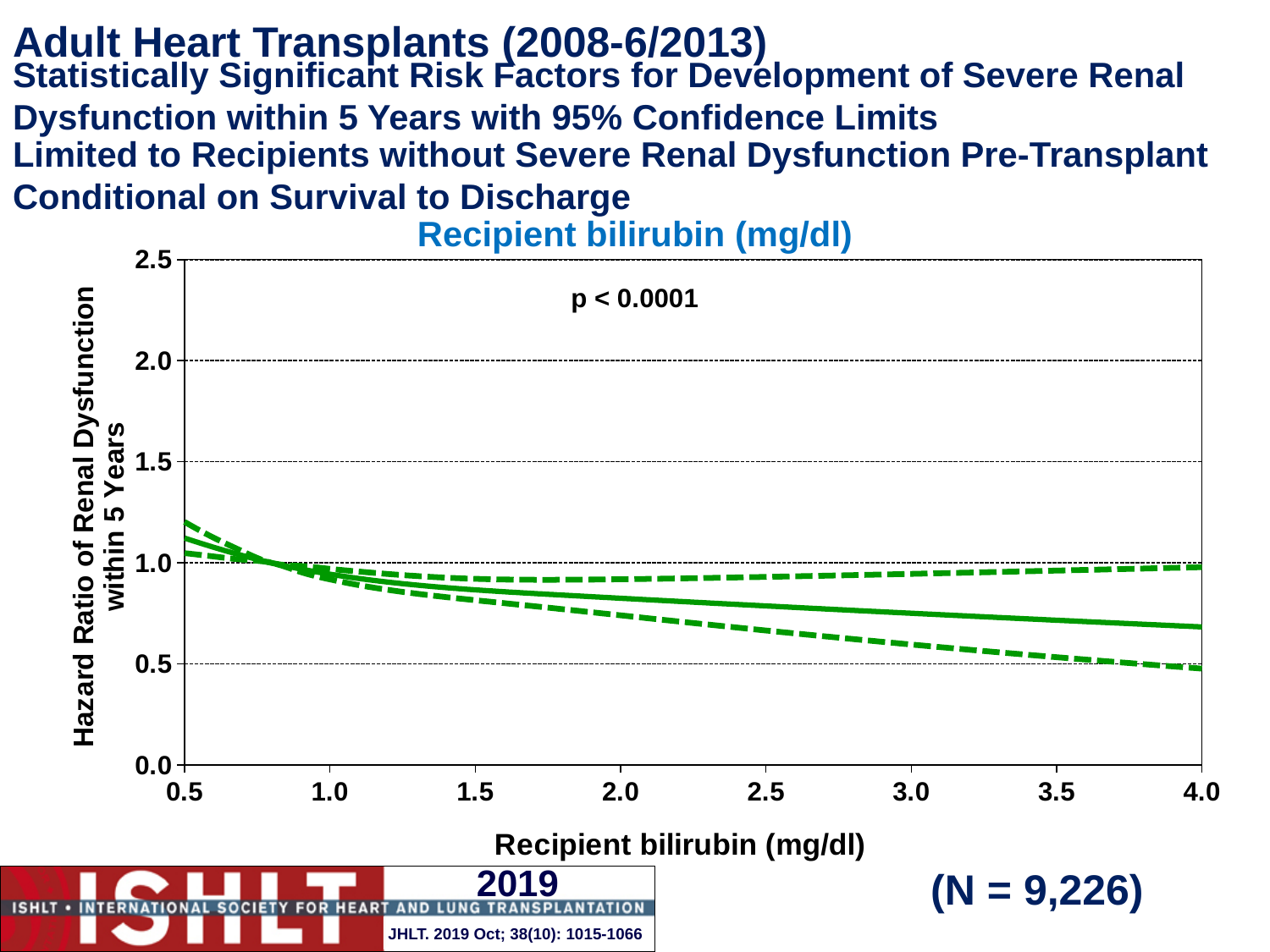
Is the hazard ratio on the solid line at a recipient bilirubin of 0.5 mg/dl greater or less than 1.5? less What is the p-value shown on the chart? p < 0.0001 Is the hazard ratio on the solid line at a recipient bilirubin of 0.5 mg/dl greater or less than 1.0? greater What is the highest value shown on the x axis of the chart? 4.0 What kind of chart is shown on the slide? line chart How many lines are plotted on the chart? 3 Does the solid hazard ratio line rise or fall as recipient bilirubin increases from 0.5 to 4.0 mg/dl? fall Is the lower dashed confidence limit at a recipient bilirubin of 4.0 mg/dl greater or less than 1.0? less What is the lowest value shown on the x axis of the chart? 0.5